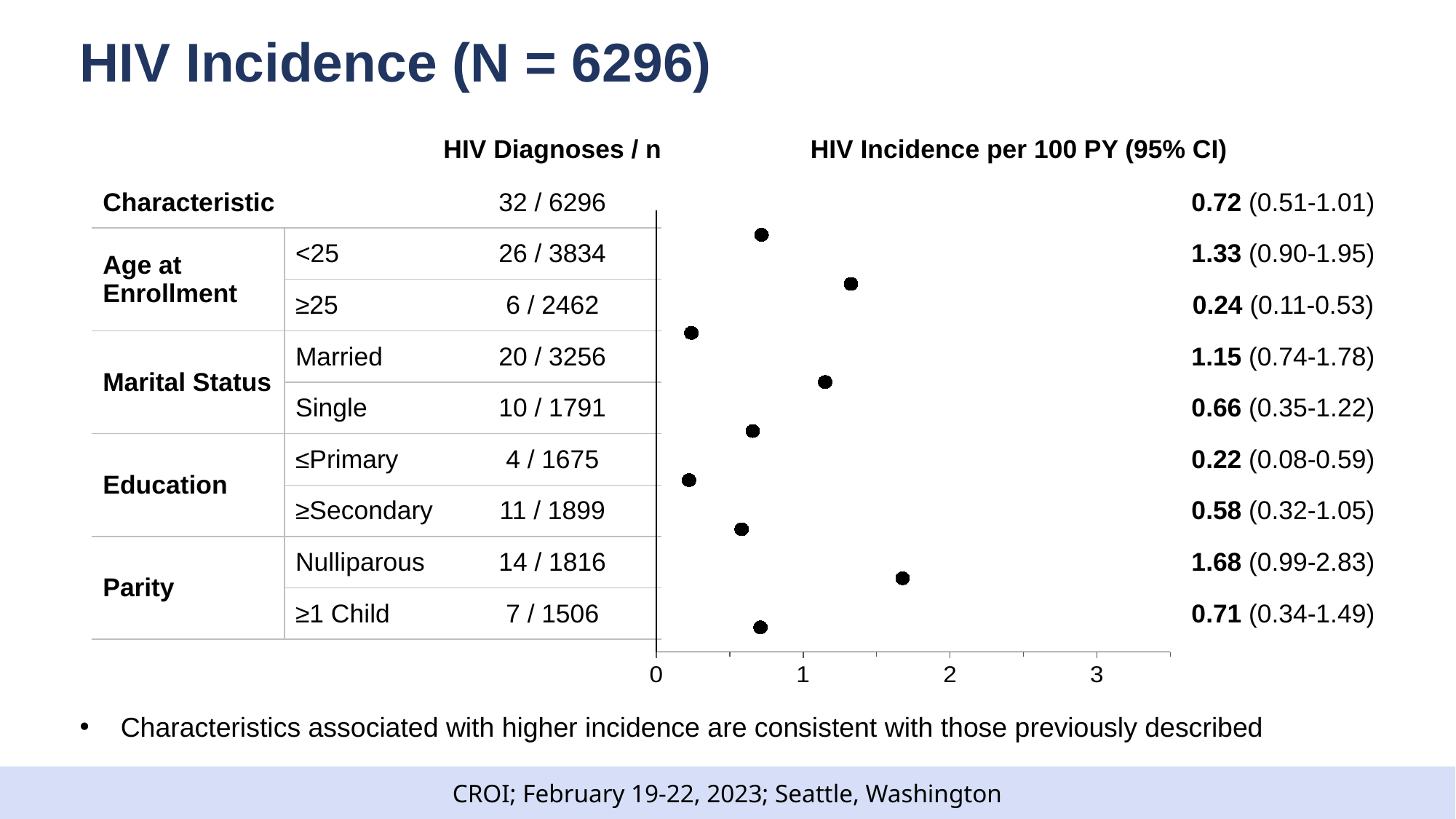
What is the difference in HIV incidence per 100 PY between the <25 and ≥25 age groups? 1.09 What is the HIV incidence per 100 PY for women aged <25 at enrollment? 1.33 What is the 95% CI for the HIV incidence among Married women? 0.74-1.78 What is the overall HIV incidence per 100 PY for the full cohort? 0.72 Which subgroup has the lowest HIV incidence per 100 PY? ≤Primary What is the highest tick value shown on the x axis of the chart? 3 How many data points are plotted in the chart? 9 How many HIV diagnoses were there among Single women, and out of how many? 10 / 1791 Is the HIV incidence per 100 PY for the ≥Secondary education group greater or less than 1? less What is the HIV incidence per 100 PY for the Nulliparous group? 1.68 Which subgroup has the highest HIV incidence per 100 PY? Nulliparous Which has a higher HIV incidence per 100 PY, Married or Single women? Married